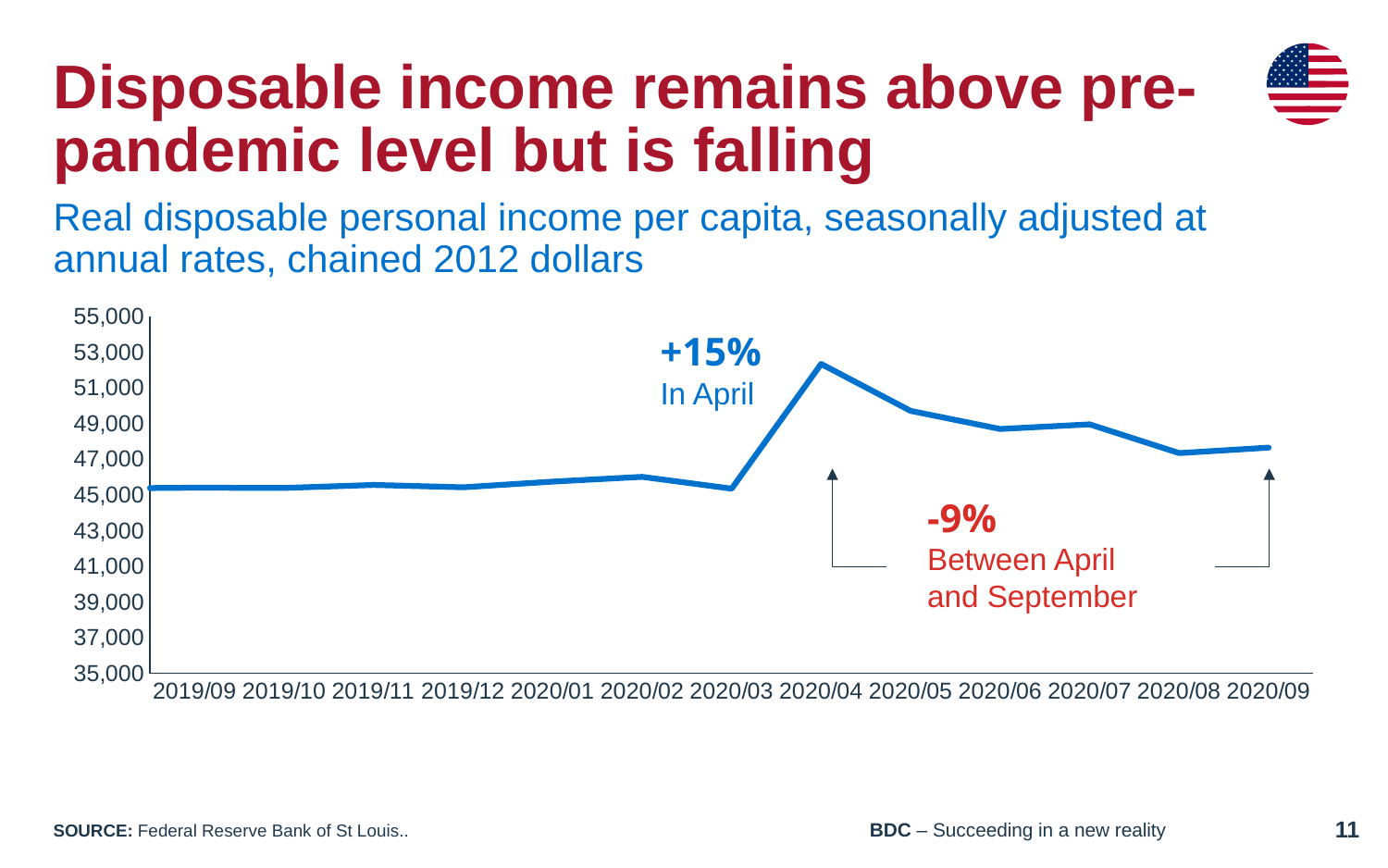
How many monthly data points are plotted on the chart? 13 Is the value for 2020/03 greater or less than 47,000? less Is the value for 2020/08 greater or less than 49,000? less Which month has the highest value on the chart? 2020/04 Is the value for 2020/04 greater or less than 51,000? greater Which is larger, the value for 2020/04 or the value for 2020/09? 2020/04 Which is larger, the value for 2020/09 or the value for 2019/09? 2020/09 What percentage change is annotated on the chart between April and September? -9% Do the values rise or fall between 2020/04 and 2020/09? fall What percentage change is annotated on the chart for April? +15% What kind of chart is shown on the slide? line chart